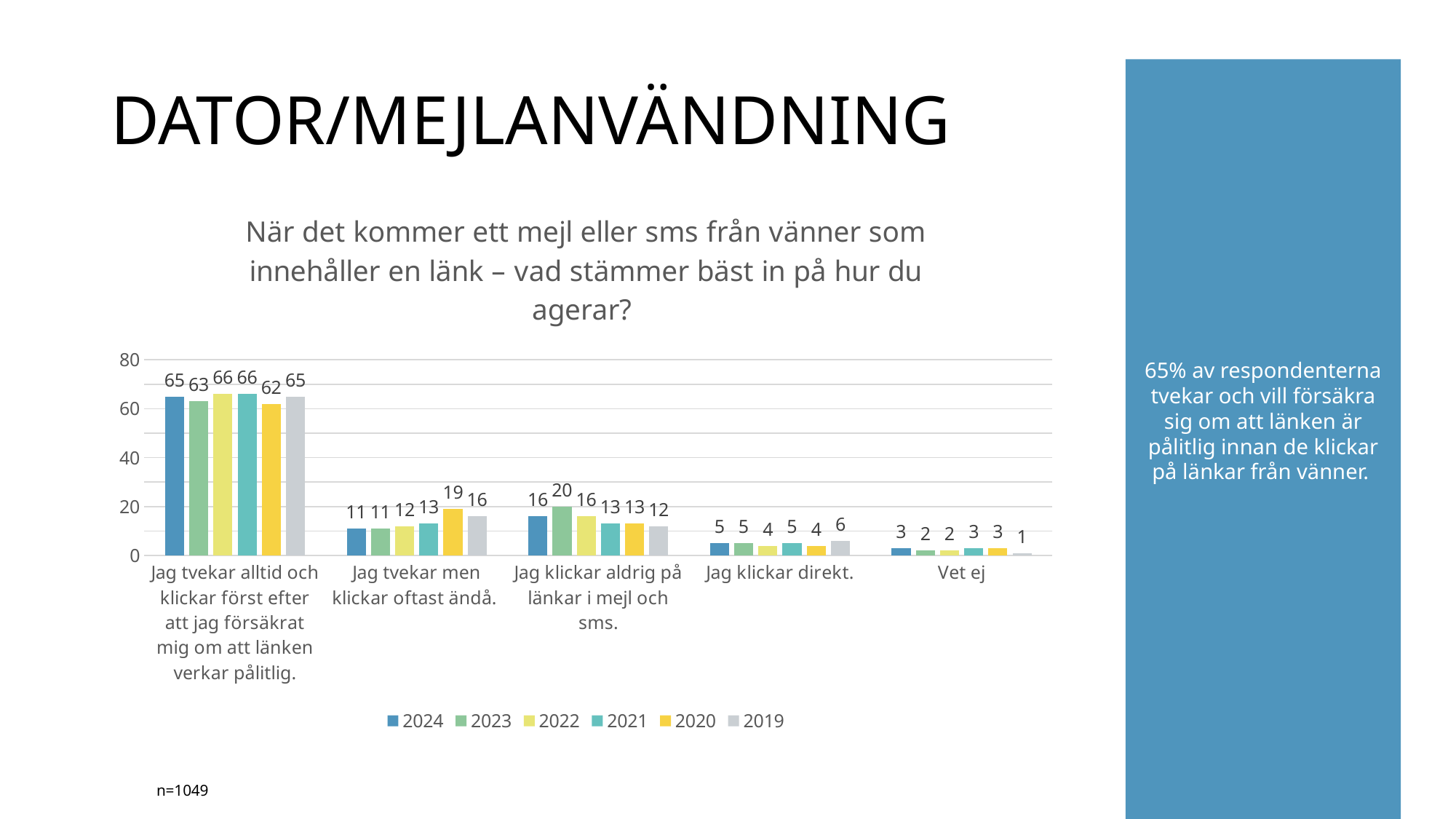
What is the value for 2020 in the category "Jag tvekar men klickar oftast ändå."? 19 What kind of chart is shown on the slide? Bar chart What is the sample size noted below the chart? n=1049 Which year has the lowest value in the category "Jag tvekar alltid och klickar först efter att jag försäkrat mig om att länken verkar pålitlig."? 2020 What is the value for 2024 in the category "Jag tvekar alltid och klickar först efter att jag försäkrat mig om att länken verkar pålitlig."? 65 How many series does the legend list? 6 What is the difference between the 2020 and 2024 values in the category "Jag tvekar men klickar oftast ändå."? 8 What is the value for 2023 in the category "Jag klickar aldrig på länkar i mejl och sms."? 20 What is the value for 2019 in the category "Vet ej"? 1 Which year has the highest value in the category "Jag klickar aldrig på länkar i mejl och sms."? 2023 Which is larger in the category "Jag klickar direkt.": the value for 2019 or the value for 2022? 2019 How many response categories are shown on the x axis? 5